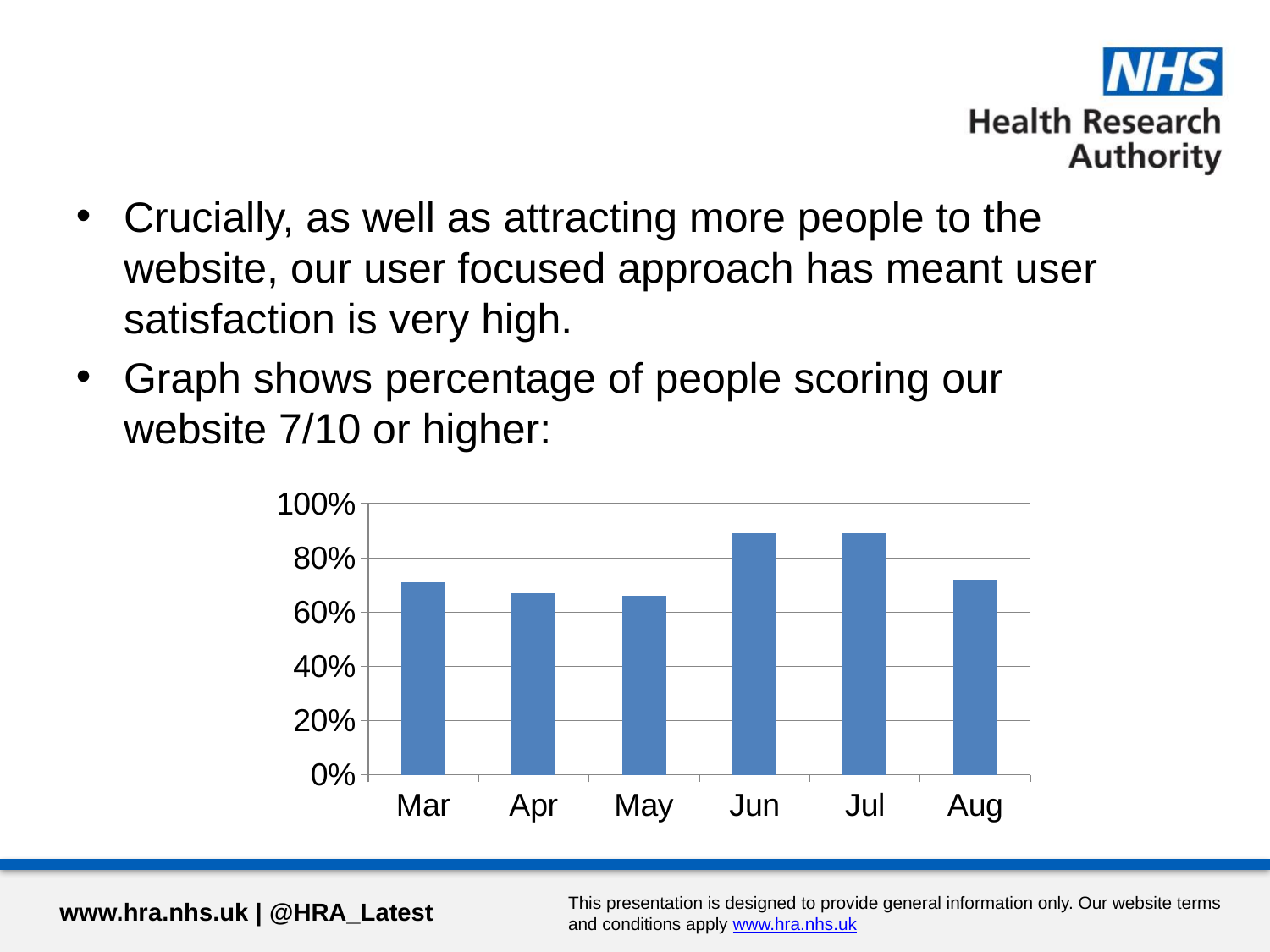
What kind of chart is shown on the slide? bar chart How many months are shown on the x axis of the chart? 6 What colour are the bars in the chart? blue Is the value for May greater or less than 80%? less Is the value for Apr greater or less than 60%? greater Is the value for Jun greater or less than 80%? greater What is the highest value shown on the y axis of the chart? 100% Which is larger, the value for Jun or the value for Apr? Jun Which is larger, the value for Mar or the value for May? Mar